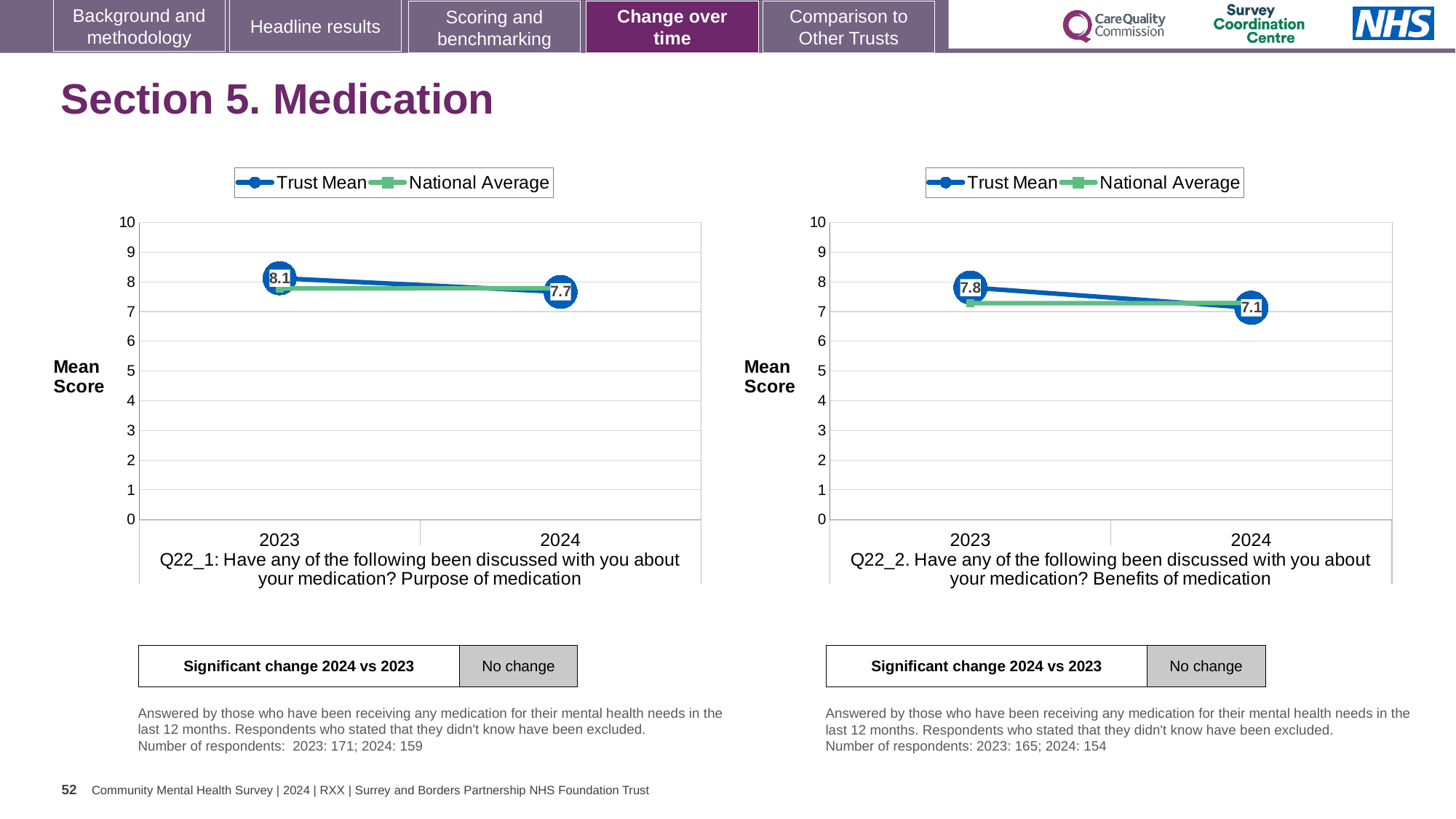
In the right chart (Q22_2), which is larger for 2023: the Trust Mean or the National Average? Trust Mean In the left chart (Q22_1: Purpose of medication), what is the Trust Mean for 2023? 8.1 In the left chart (Q22_1), by how much did the Trust Mean change from 2023 to 2024? 0.4 What kind of chart is the left chart (Q22_1)? line chart In the right chart (Q22_2), what is the difference between the Trust Mean in 2023 and in 2024? 0.7 In the right chart (Q22_2), does the Trust Mean rise or fall from 2023 to 2024? fall In the right chart (Q22_2: Benefits of medication), what is the Trust Mean for 2023? 7.8 In the right chart (Q22_2), is the National Average for 2023 greater or less than 8? less In the left chart (Q22_1: Purpose of medication), what is the Trust Mean for 2024? 7.7 How many series does the legend of the right chart (Q22_2) list? 2 In the right chart (Q22_2: Benefits of medication), what is the Trust Mean for 2024? 7.1 How many years are plotted on the x axis of the left chart (Q22_1)? 2